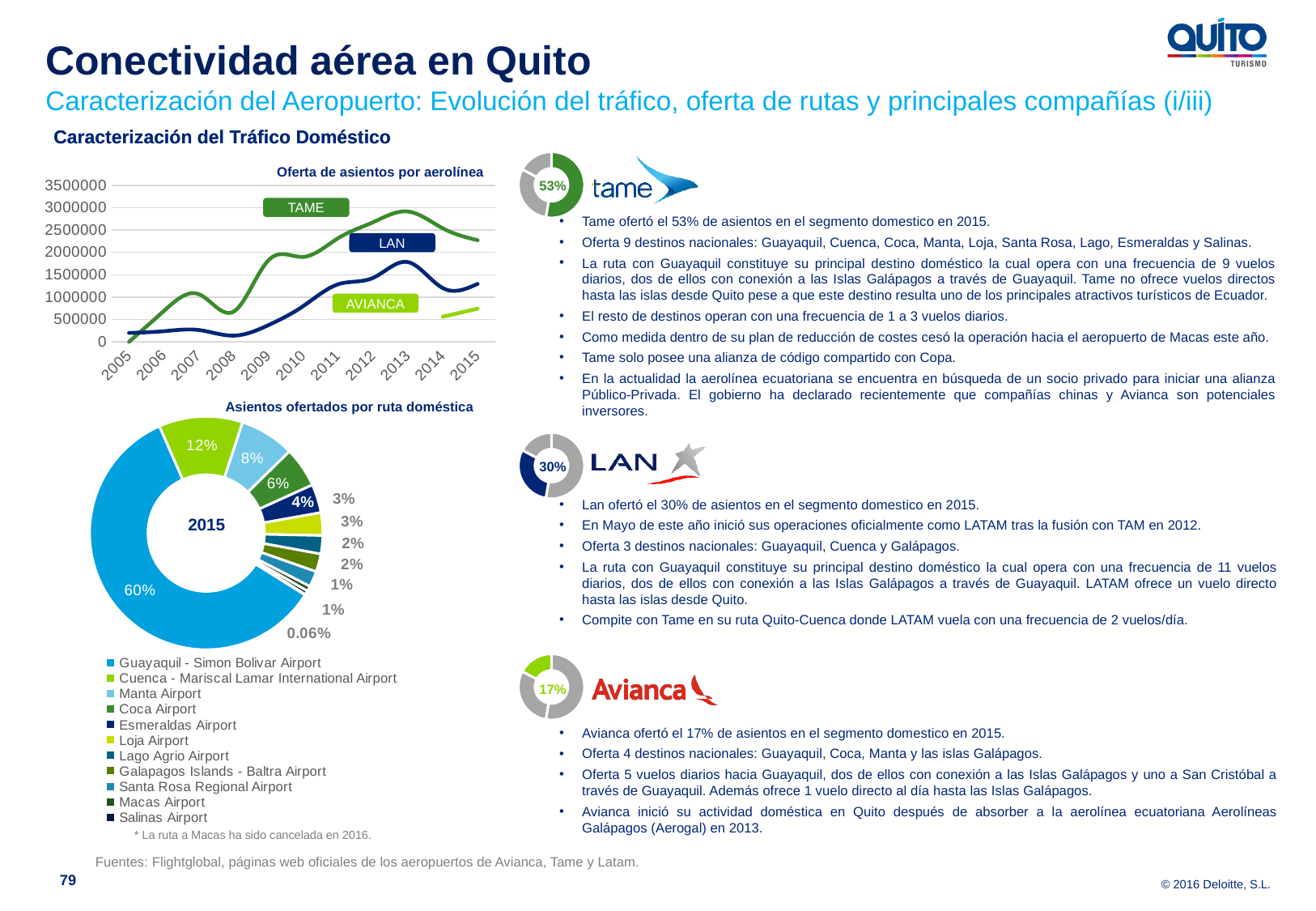
What kind of chart is 'Asientos ofertados por ruta doméstica'? doughnut chart In the 'Oferta de asientos por aerolínea' chart, which is larger in 2015, TAME or LAN? TAME In the 'Asientos ofertados por ruta doméstica' chart, what is the difference between the shares of Manta Airport and Coca Airport? 2% In the 'Oferta de asientos por aerolínea' chart, which airline has the highest seat offer in 2013? TAME How many series does the 'Oferta de asientos por aerolínea' chart show? 3 In the 'Asientos ofertados por ruta doméstica' chart, what share does Cuenca - Mariscal Lamar International Airport have? 12% What year is shown in the centre of the 'Asientos ofertados por ruta doméstica' chart? 2015 In the 'Asientos ofertados por ruta doméstica' chart, what share does Guayaquil - Simon Bolivar Airport have? 60% In the 'Oferta de asientos por aerolínea' chart, is the value for TAME in 2013 greater or less than 2500000? greater In the 'Oferta de asientos por aerolínea' chart, is the value for LAN in 2008 greater or less than 500000? less In the 'Oferta de asientos por aerolínea' chart, is the value for AVIANCA in 2015 greater or less than 1000000? less What kind of chart is 'Oferta de asientos por aerolínea'? line chart